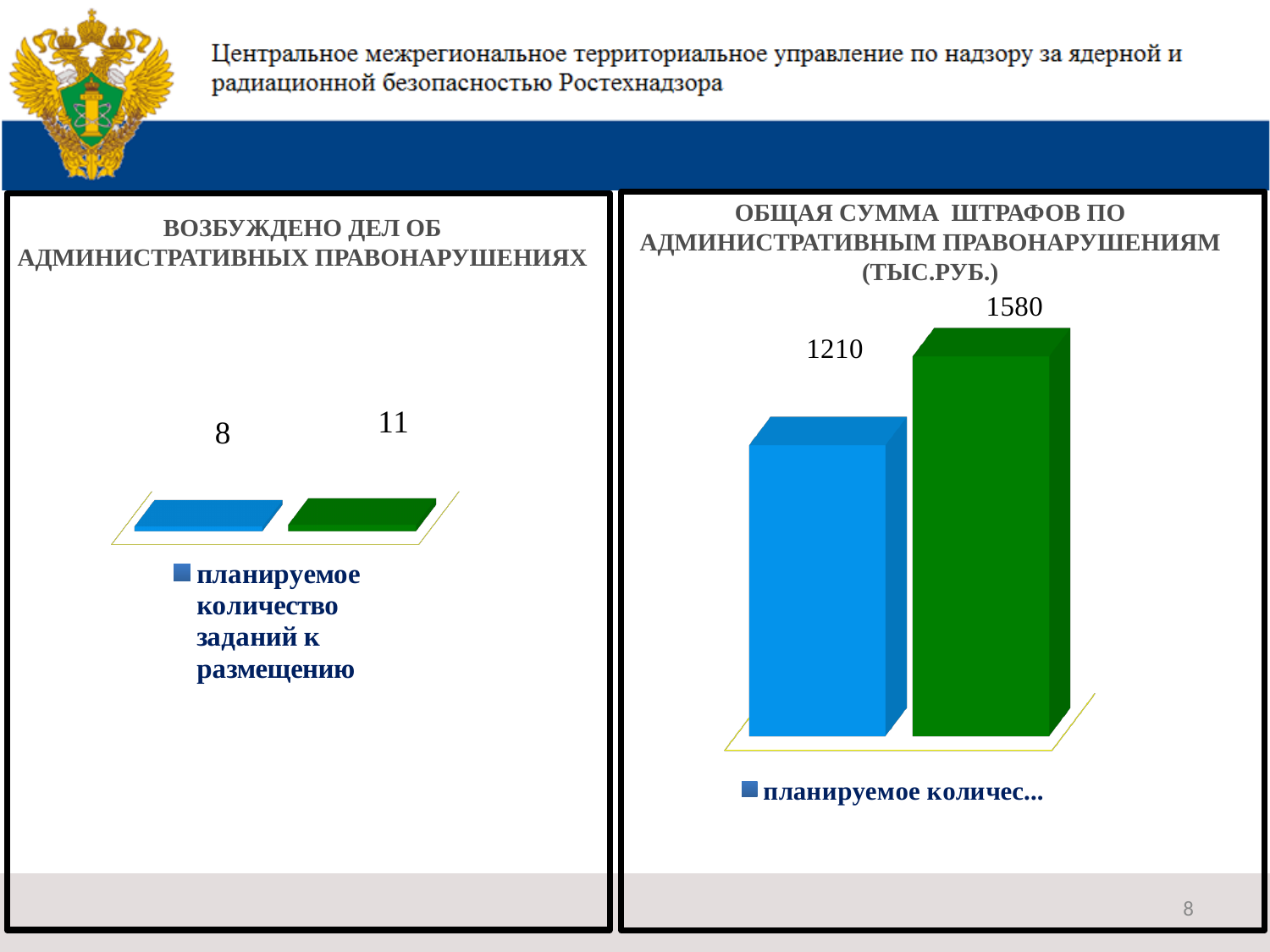
What kind of chart is the right chart 'ОБЩАЯ СУММА ШТРАФОВ ПО АДМИНИСТРАТИВНЫМ ПРАВОНАРУШЕНИЯМ (ТЫС.РУБ.)'? bar chart In the right chart 'ОБЩАЯ СУММА ШТРАФОВ ПО АДМИНИСТРАТИВНЫМ ПРАВОНАРУШЕНИЯМ (ТЫС.РУБ.)', what value is shown on the blue bar? 1210 In the left chart 'ВОЗБУЖДЕНО ДЕЛ ОБ АДМИНИСТРАТИВНЫХ ПРАВОНАРУШЕНИЯХ', what value is shown on the blue bar? 8 In the left chart 'ВОЗБУЖДЕНО ДЕЛ ОБ АДМИНИСТРАТИВНЫХ ПРАВОНАРУШЕНИЯХ', which bar has the higher value, the blue or the green? green In the right chart 'ОБЩАЯ СУММА ШТРАФОВ ПО АДМИНИСТРАТИВНЫМ ПРАВОНАРУШЕНИЯМ (ТЫС.РУБ.)', what is the difference between the green bar and the blue bar? 370 What unit is given in the title of the right chart? ТЫС.РУБ. In the left chart 'ВОЗБУЖДЕНО ДЕЛ ОБ АДМИНИСТРАТИВНЫХ ПРАВОНАРУШЕНИЯХ', what is the difference between the green bar and the blue bar? 3 In the right chart 'ОБЩАЯ СУММА ШТРАФОВ ПО АДМИНИСТРАТИВНЫМ ПРАВОНАРУШЕНИЯМ (ТЫС.РУБ.)', what value is shown on the green bar? 1580 In the right chart 'ОБЩАЯ СУММА ШТРАФОВ ПО АДМИНИСТРАТИВНЫМ ПРАВОНАРУШЕНИЯМ (ТЫС.РУБ.)', what is the highest value shown? 1580 In the left chart 'ВОЗБУЖДЕНО ДЕЛ ОБ АДМИНИСТРАТИВНЫХ ПРАВОНАРУШЕНИЯХ', what value is shown on the green bar? 11 How many bars are plotted in the left chart 'ВОЗБУЖДЕНО ДЕЛ ОБ АДМИНИСТРАТИВНЫХ ПРАВОНАРУШЕНИЯХ'? 2 In the right chart 'ОБЩАЯ СУММА ШТРАФОВ ПО АДМИНИСТРАТИВНЫМ ПРАВОНАРУШЕНИЯМ (ТЫС.РУБ.)', what is the lowest value shown? 1210